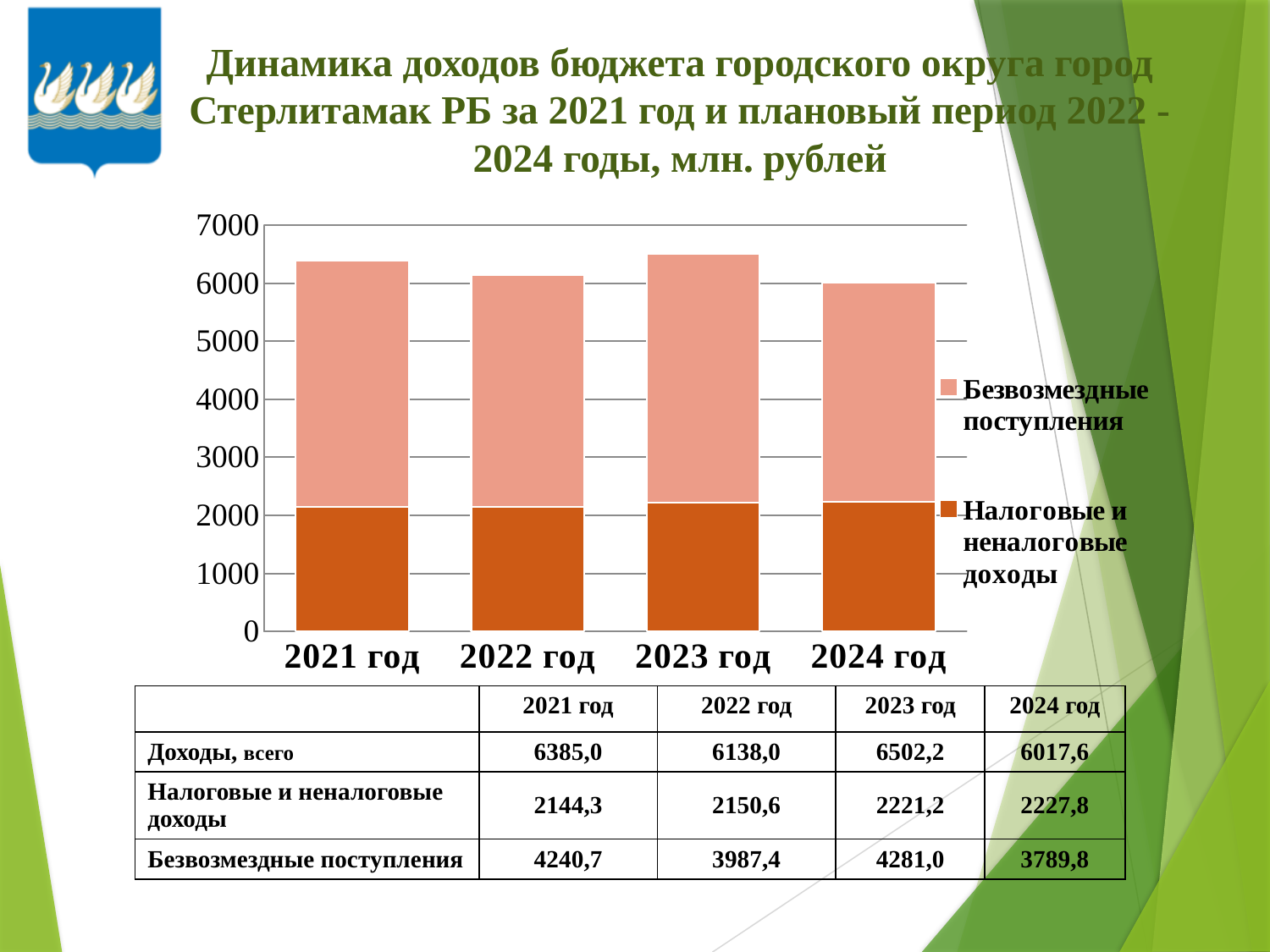
What is the total income (Доходы, всего) for 2024 год? 6017,6 Which is larger: Безвозмездные поступления in 2021 год or in 2022 год? 2021 год What type of chart is shown on the slide? Stacked bar chart What is the difference between Безвозмездные поступления in 2023 год and 2024 год? 491,2 What is the value of Налоговые и неналоговые доходы for 2021 год? 2144,3 Which year has the lowest value of Безвозмездные поступления? 2024 год Which series is shown in the darker orange colour at the bottom of each bar? Налоговые и неналоговые доходы What is the value of Безвозмездные поступления for 2023 год? 4281,0 Is the total income for 2023 год greater or less than 6000? greater How many series does the chart legend list? 2 Which year has the highest total income (Доходы, всего)? 2023 год How many years (categories) are shown on the x axis of the chart? 4